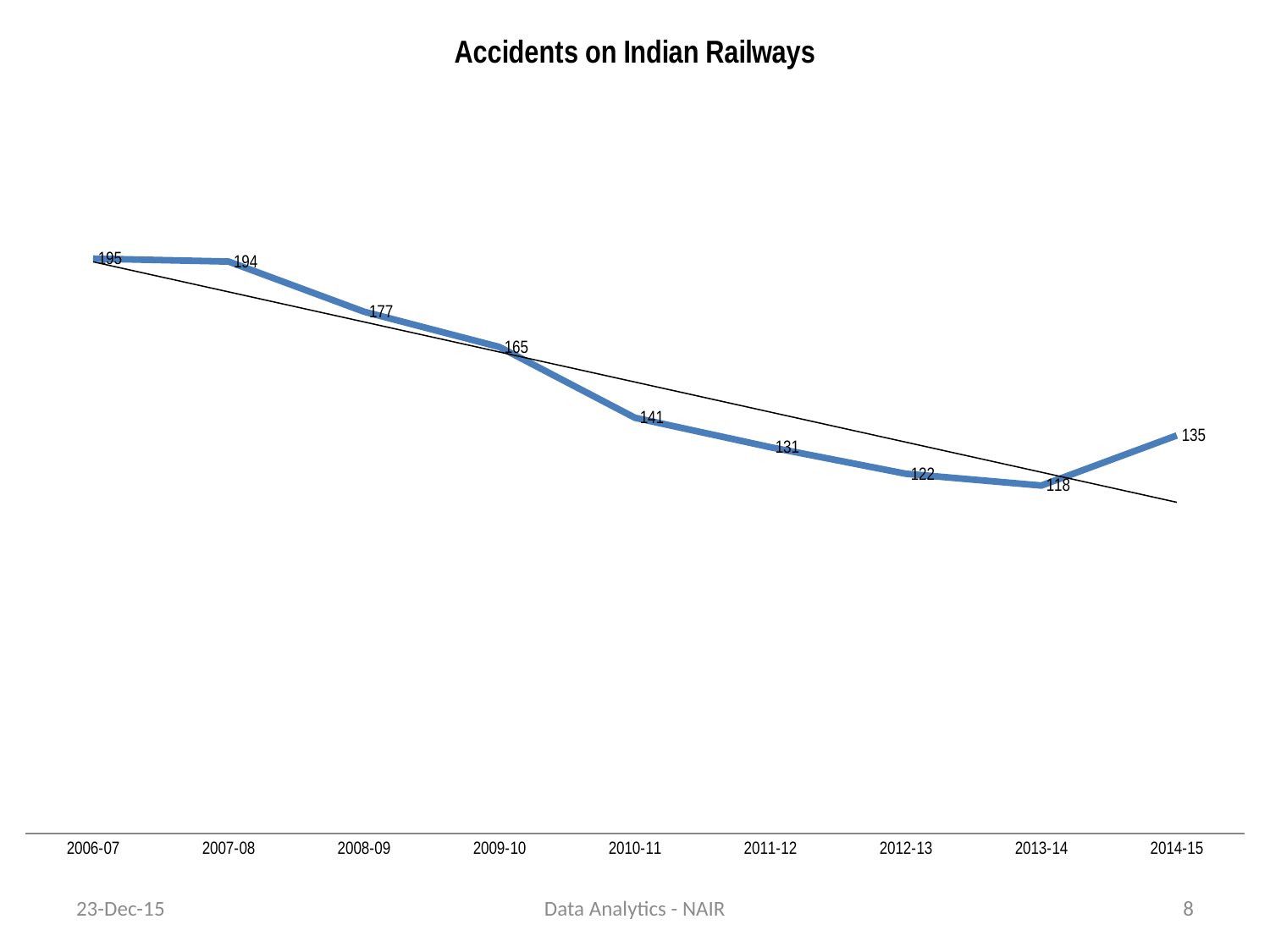
How many years are plotted on the x axis? 9 What is the value for 2010-11? 141 What is the value for 2006-07? 195 What is the title of the chart? Accidents on Indian Railways What kind of chart is this? Line chart What is the difference between the values for 2006-07 and 2013-14? 77 What is the value for 2014-15? 135 Which year has the lowest value? 2013-14 Which year has the highest value? 2006-07 Which is larger, the value for 2012-13 or the value for 2014-15? 2014-15 What is the difference between the values for 2009-10 and 2010-11? 24 Do the values generally rise or fall from 2006-07 to 2013-14? Fall